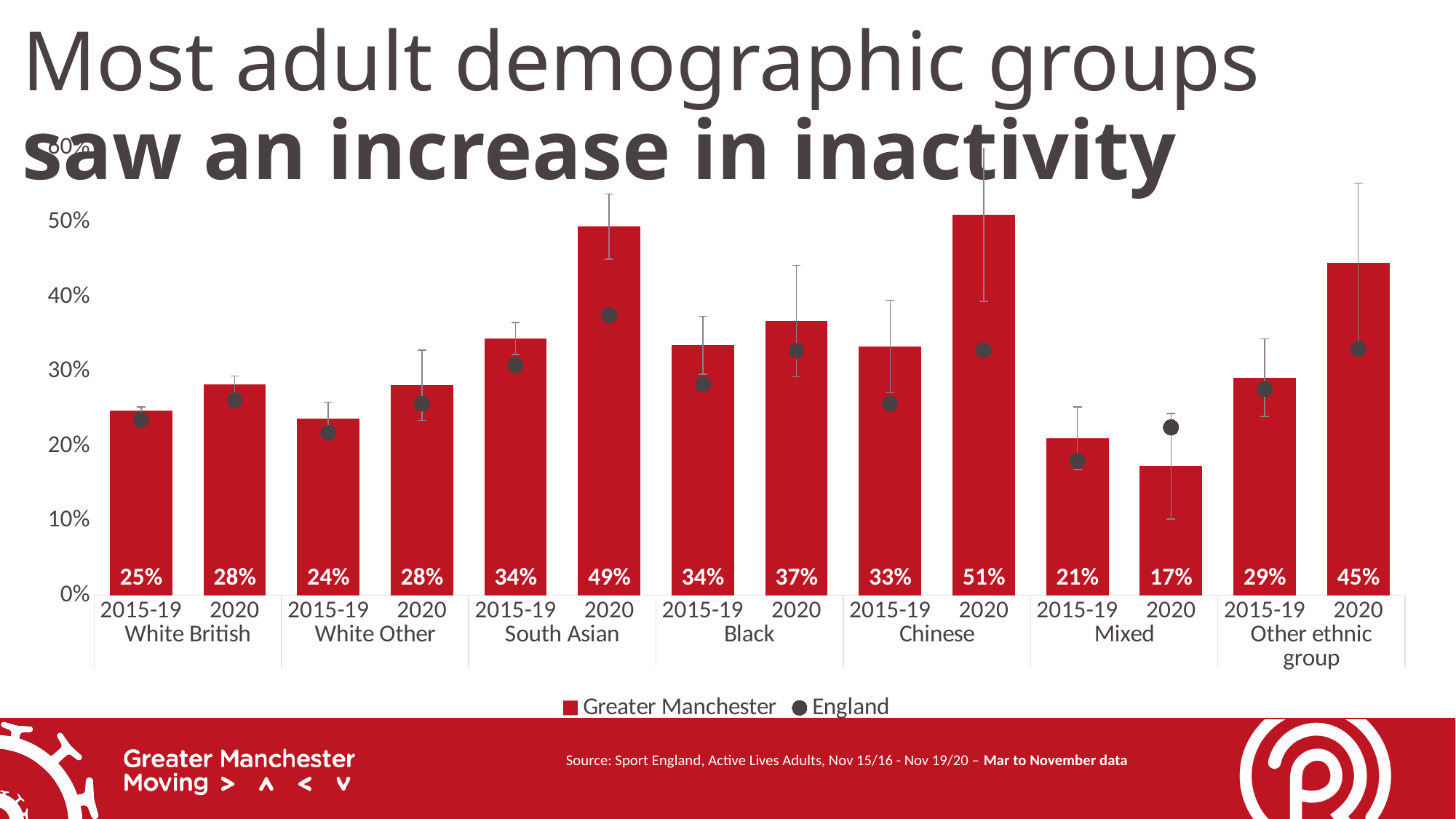
What is the difference between the Greater Manchester values for Chinese adults in 2020 and 2015-19? 18 percentage points Is the England value (dot) for South Asian adults in 2020 greater or less than 40%? less What is the Greater Manchester value for White British adults in 2015-19? 25% What is the Greater Manchester inactivity value for South Asian adults in 2020? 49% Which bar has the lowest Greater Manchester value on the chart? Mixed 2020 (17%) What is the Greater Manchester value for Mixed adults in 2020? 17% What kind of chart is shown on the slide? Bar chart (with dot markers for England) Which bar has the highest Greater Manchester value on the chart? Chinese 2020 (51%) How many ethnic groups are shown on the x axis? 7 How many series does the legend list? 2 Which is larger for Greater Manchester: Black adults in 2020 or Other ethnic group adults in 2020? Other ethnic group 2020 (45%) Which series is shown as red bars in the legend? Greater Manchester